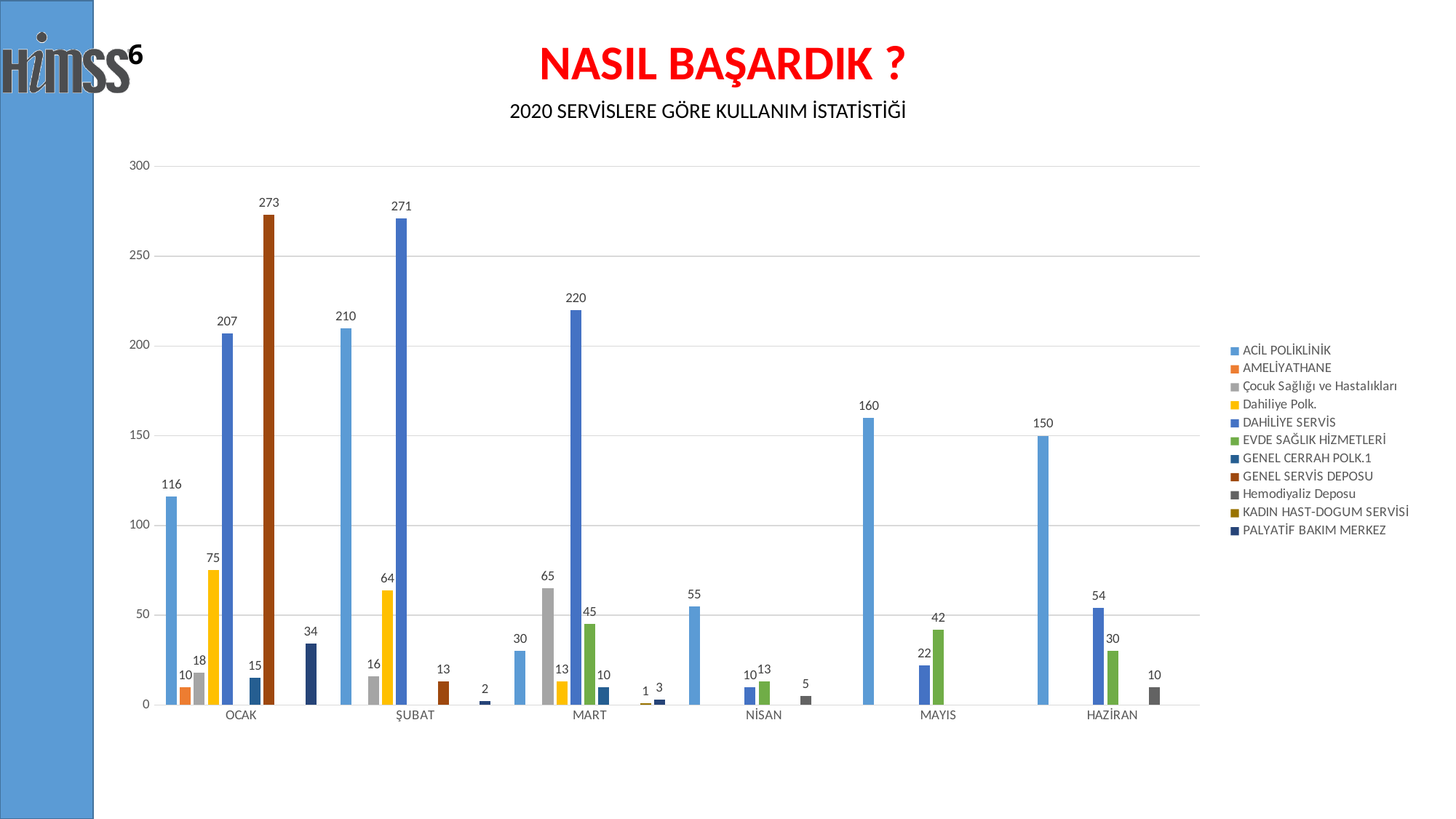
How many month categories are shown on the x axis? 6 How many series does the legend list? 11 What is the value for DAHİLİYE SERVİS in ŞUBAT? 271 What type of chart is shown on the slide? bar chart Which is larger in MART: Çocuk Sağlığı ve Hastalıkları or EVDE SAĞLIK HİZMETLERİ? Çocuk Sağlığı ve Hastalıkları What is the title of the chart? 2020 SERVİSLERE GÖRE KULLANIM İSTATİSTİĞİ In which month is the ACİL POLİKLİNİK value highest? ŞUBAT What is the value for GENEL SERVİS DEPOSU in OCAK? 273 Does the ACİL POLİKLİNİK value in OCAK rise or fall from OCAK to ŞUBAT? rise What is the value for ACİL POLİKLİNİK in MAYIS? 160 In which month is the DAHİLİYE SERVİS value lowest? NİSAN What is the difference between the ACİL POLİKLİNİK values in MAYIS and HAZİRAN? 10